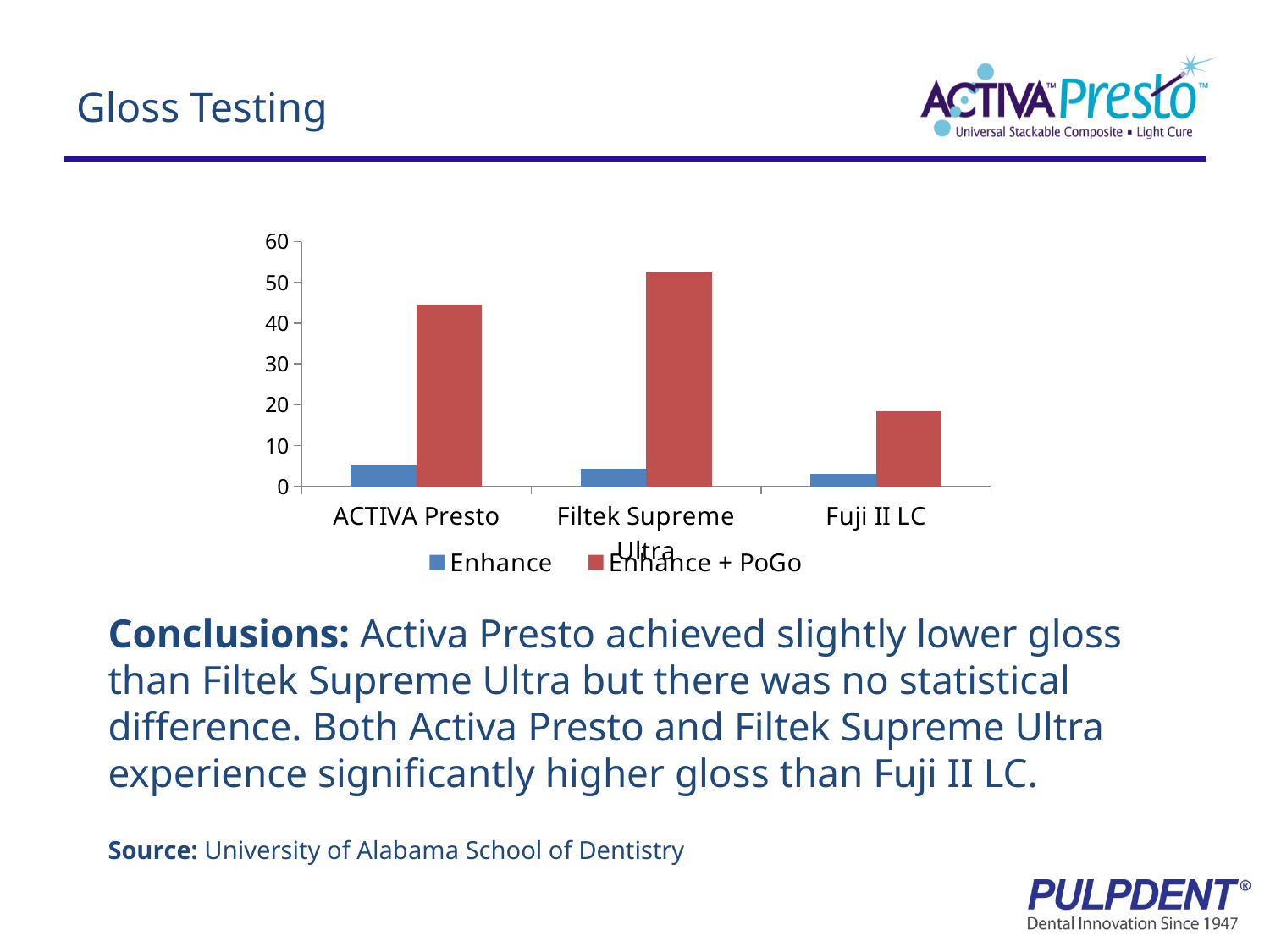
Is the Enhance + PoGo value for Filtek Supreme Ultra greater or less than 50? greater What kind of chart is shown on the slide? bar chart Is the Enhance + PoGo value for Fuji II LC greater or less than 20? less Which material has the lowest Enhance + PoGo value? Fuji II LC Is the Enhance + PoGo value for ACTIVA Presto greater or less than 40? greater Which is larger for Fuji II LC: the Enhance value or the Enhance + PoGo value? Enhance + PoGo How many series does the legend list? 2 Which material has the highest Enhance + PoGo value? Filtek Supreme Ultra How many material categories are shown on the x axis? 3 Which series is shown in red in the legend? Enhance + PoGo